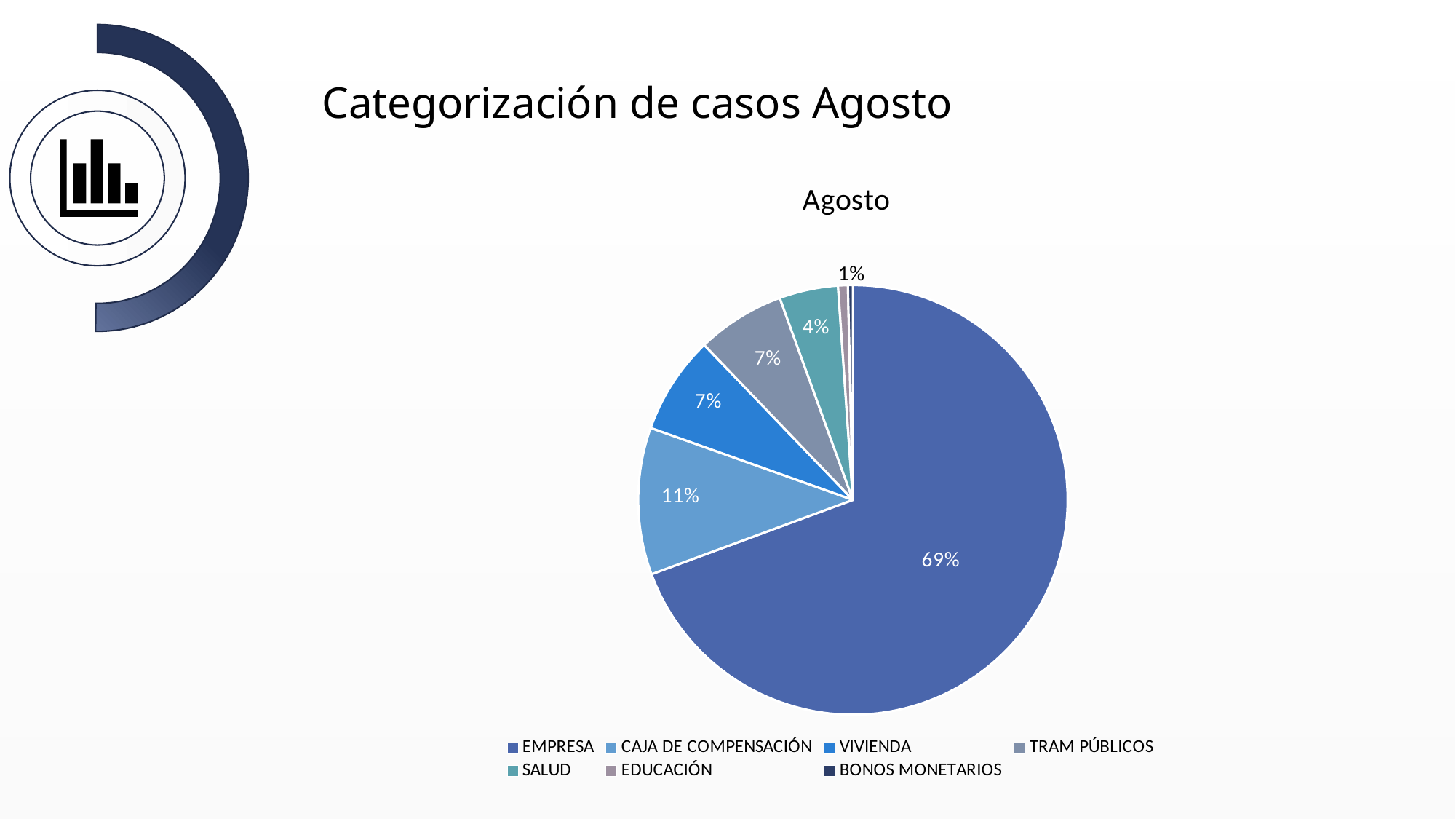
What share of the pie does EMPRESA have? 69% What is the value for CAJA DE COMPENSACIÓN? 11% What is the value for SALUD? 4% What is the title of the chart? Agosto What kind of chart is shown on the slide? pie chart What is the difference in percentage points between EMPRESA and CAJA DE COMPENSACIÓN? 58 How many categories does the legend list? 7 Which is larger, CAJA DE COMPENSACIÓN or VIVIENDA? CAJA DE COMPENSACIÓN What is the value for VIVIENDA? 7% Which category has the largest slice of the pie? EMPRESA What is the difference in percentage points between VIVIENDA and SALUD? 3 Which is larger, SALUD or TRAM PÚBLICOS? TRAM PÚBLICOS